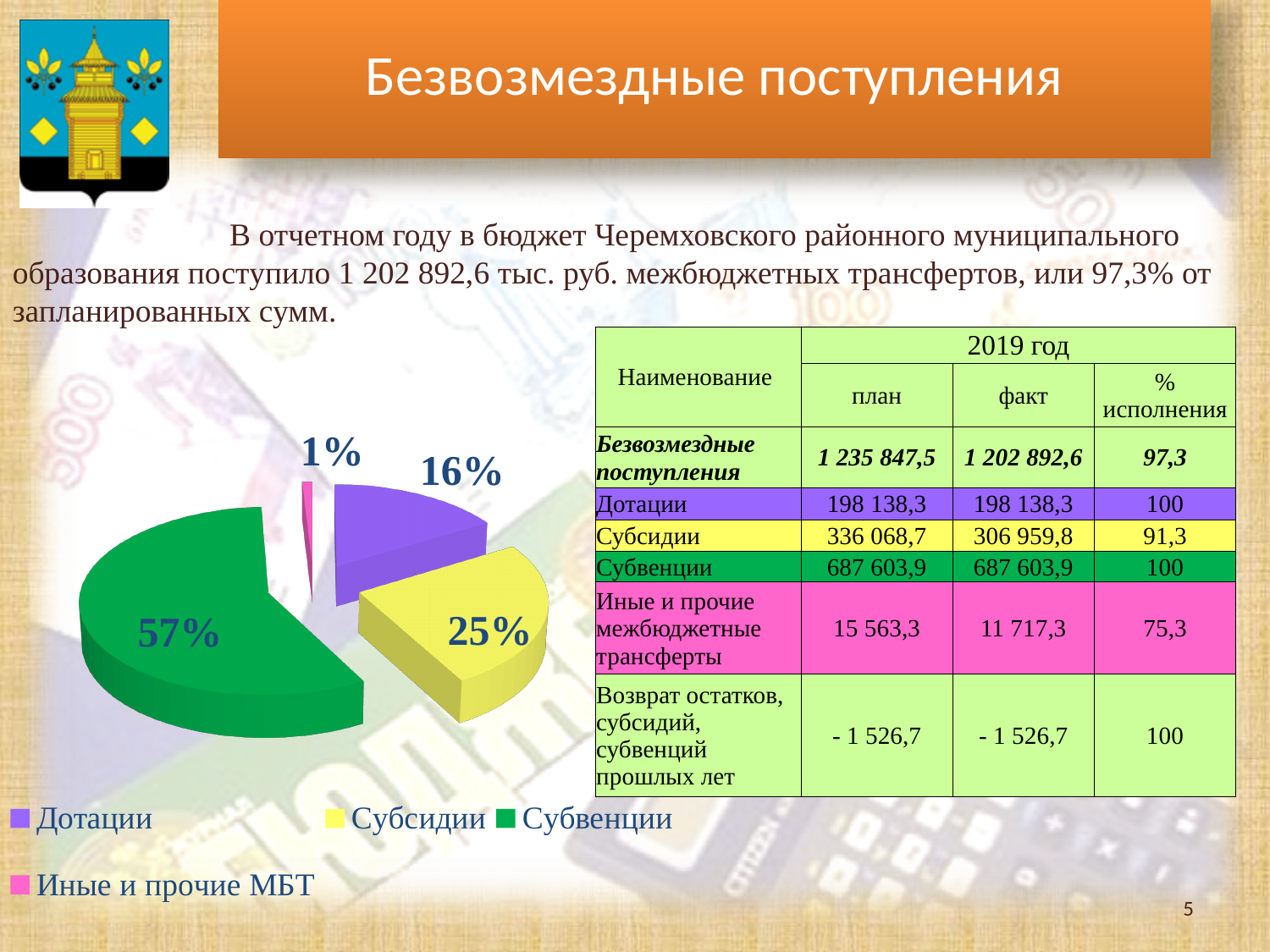
What kind of chart is shown on the slide? pie chart What share of the pie chart does Субвенции take? 57% What share of the pie chart does Иные и прочие МБТ take? 1% Which slice is larger in the pie chart, Дотации or Субсидии? Субсидии What colour is the Субвенции slice in the pie chart? green How many slices does the pie chart have? 4 Which category has the largest slice in the pie chart? Субвенции Which category has the smallest slice in the pie chart? Иные и прочие МБТ How many entries does the legend of the pie chart list? 4 What share of the pie chart does Субсидии take? 25% By how many percentage points does the Субвенции slice exceed the Субсидии slice? 32